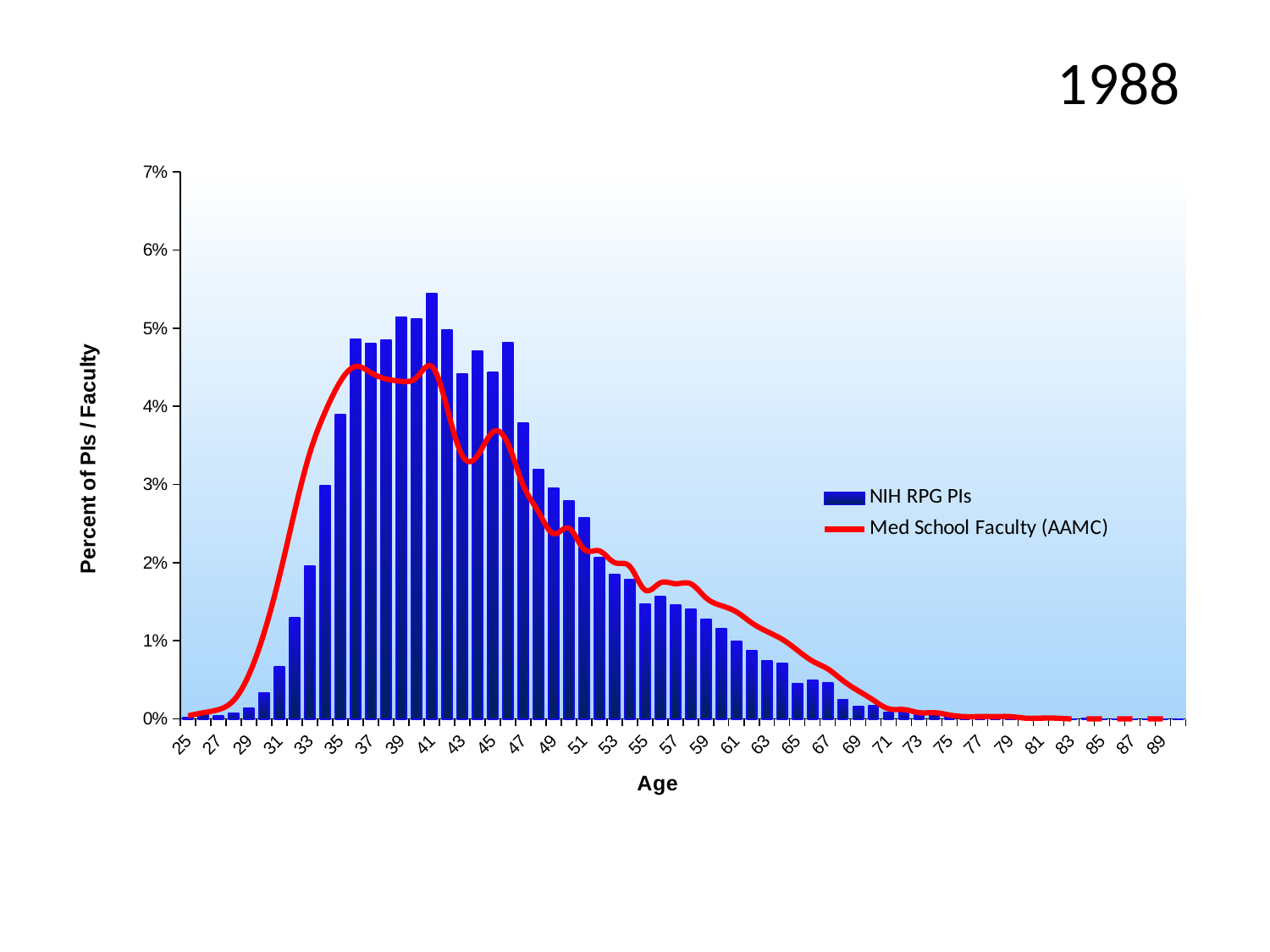
How many series does the legend list? 2 Is the NIH RPG PIs value at age 31 greater or less than 1%? less What kind of chart is shown on the slide? A bar chart with a line series At age 33, which is larger: the NIH RPG PIs bar or the Med School Faculty (AAMC) line? Med School Faculty (AAMC) Is the NIH RPG PIs value at age 47 greater or less than 3%? greater At age 41, which is larger: the NIH RPG PIs bar or the Med School Faculty (AAMC) line? NIH RPG PIs At which age is the NIH RPG PIs bar highest? 41 Do the NIH RPG PIs bars generally rise or fall from age 47 to age 69? fall Is the Med School Faculty (AAMC) value at age 36 greater or less than 4%? greater What is the title of the y axis? Percent of PIs / Faculty